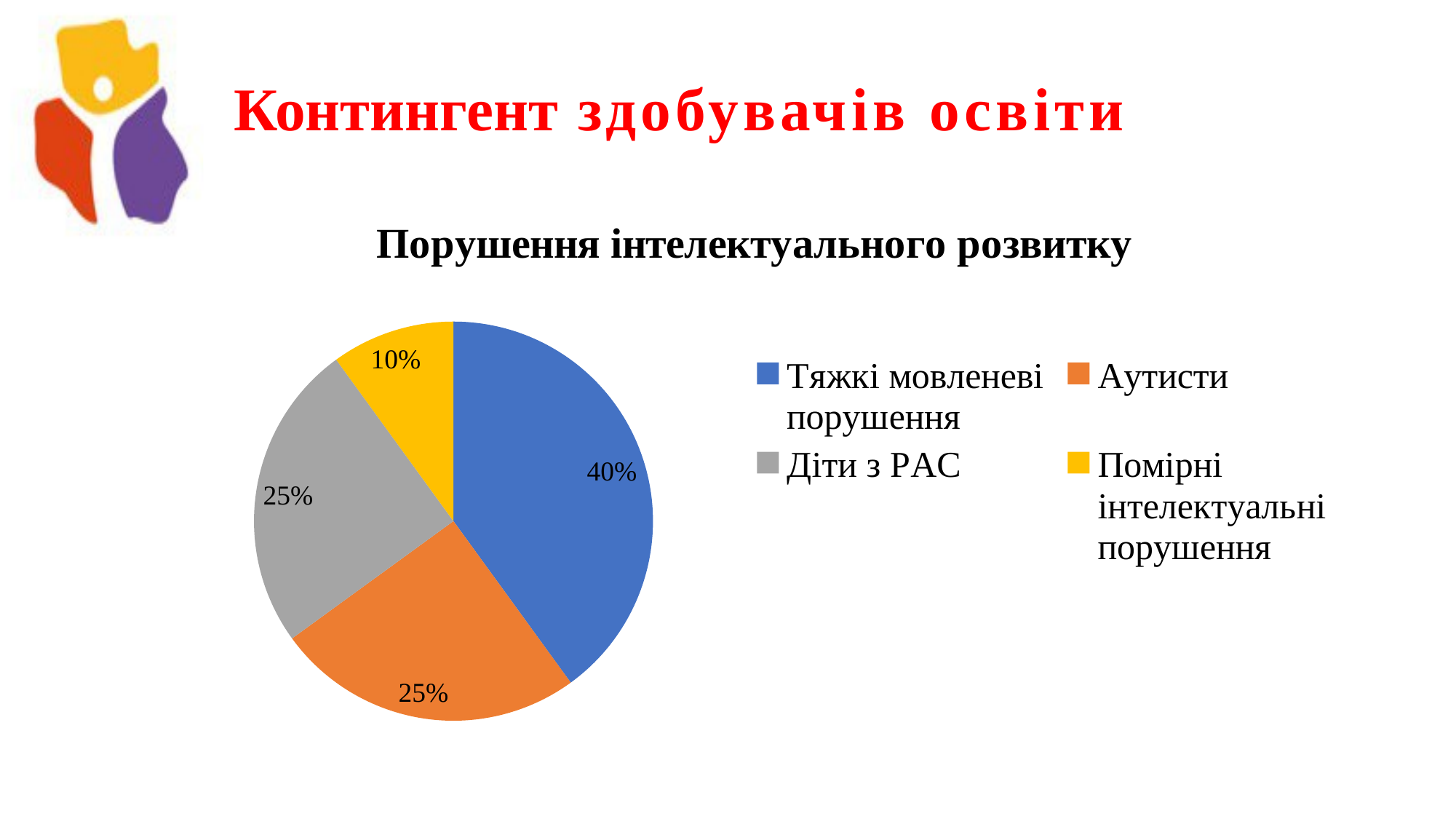
What share of the pie is labelled for Тяжкі мовленеві порушення? 40% What type of chart is shown on the slide? Pie chart Which is larger: the share for Аутисти or the share for Помірні інтелектуальні порушення? Аутисти What colour is the slice for Діти з РАС? Grey How many categories does the pie chart show? 4 What is the difference between the share for Тяжкі мовленеві порушення and the share for Помірні інтелектуальні порушення? 30% What share of the pie is labelled for Аутисти? 25% What is the title of the chart? Порушення інтелектуального розвитку Which category has the smallest slice of the pie? Помірні інтелектуальні порушення What share of the pie is labelled for Діти з РАС? 25% Which category has the largest slice of the pie? Тяжкі мовленеві порушення What share of the pie is labelled for Помірні інтелектуальні порушення? 10%